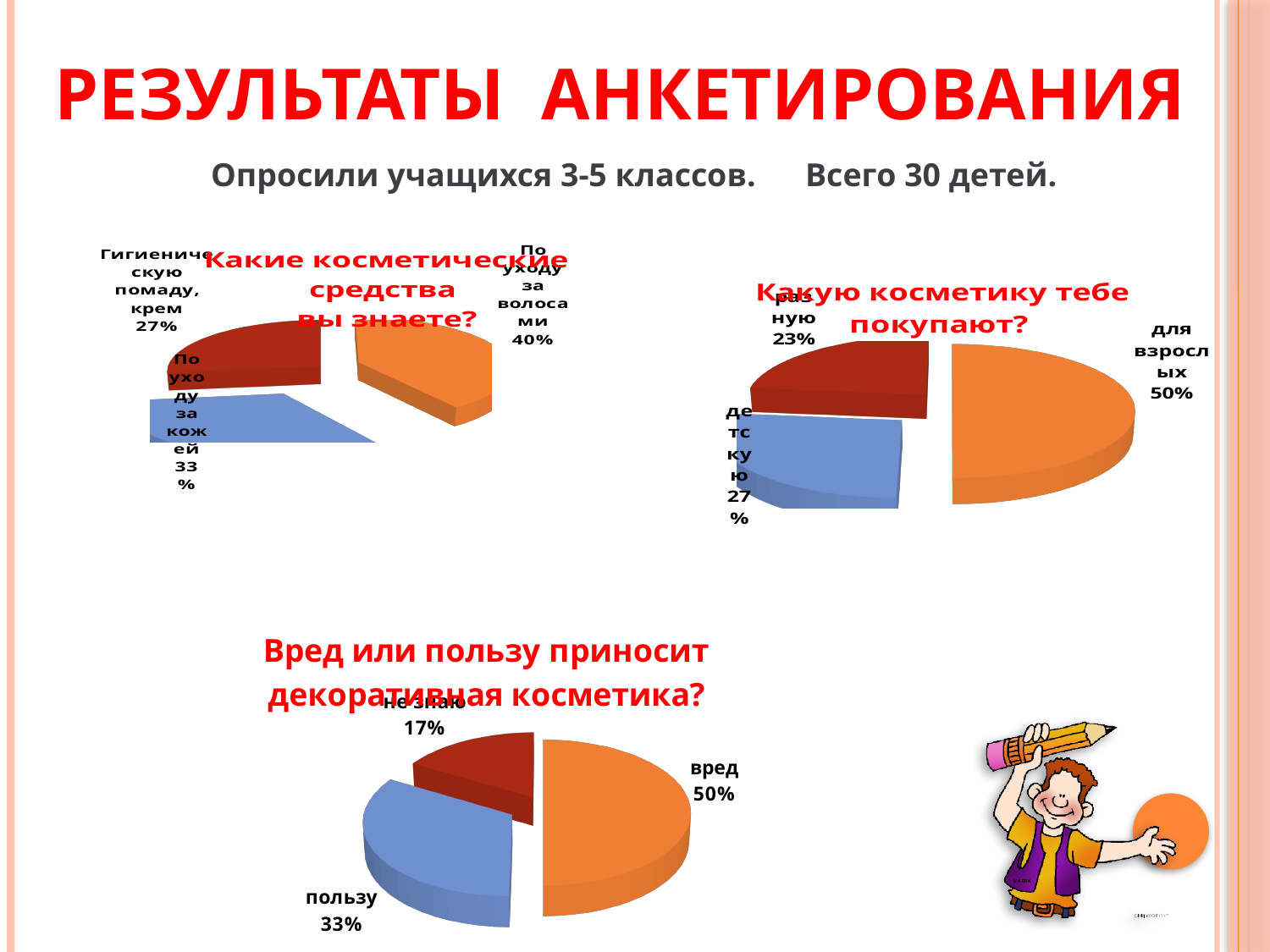
In the chart 'Какую косметику тебе покупают?', what is the difference between the 'детскую' and 'разную' shares? 4% In the chart 'Вред или пользу приносит декоративная косметика?', which is larger: 'вред' or 'пользу'? вред How many charts are shown on the slide? 3 In the chart 'Какую косметику тебе покупают?', which category has the largest share? для взрослых In the chart 'Какие косметические средства вы знаете?', how many slices does the pie have? 3 In the chart 'Какие косметические средства вы знаете?', which category has the smallest share? Гигиеническую помаду, крем In the chart 'Какую косметику тебе покупают?', what share is labelled 'для взрослых'? 50% In the chart 'Вред или пользу приносит декоративная косметика?', what share is labelled 'пользу'? 33% In the chart 'Какую косметику тебе покупают?', what share is labelled 'разную'? 23% In the chart 'Вред или пользу приносит декоративная косметика?', which category has the smallest share? не знаю What type of chart is used for 'Вред или пользу приносит декоративная косметика?'? Pie chart In the chart 'Какие косметические средства вы знаете?', what share is labelled 'По уходу за волосами'? 40%